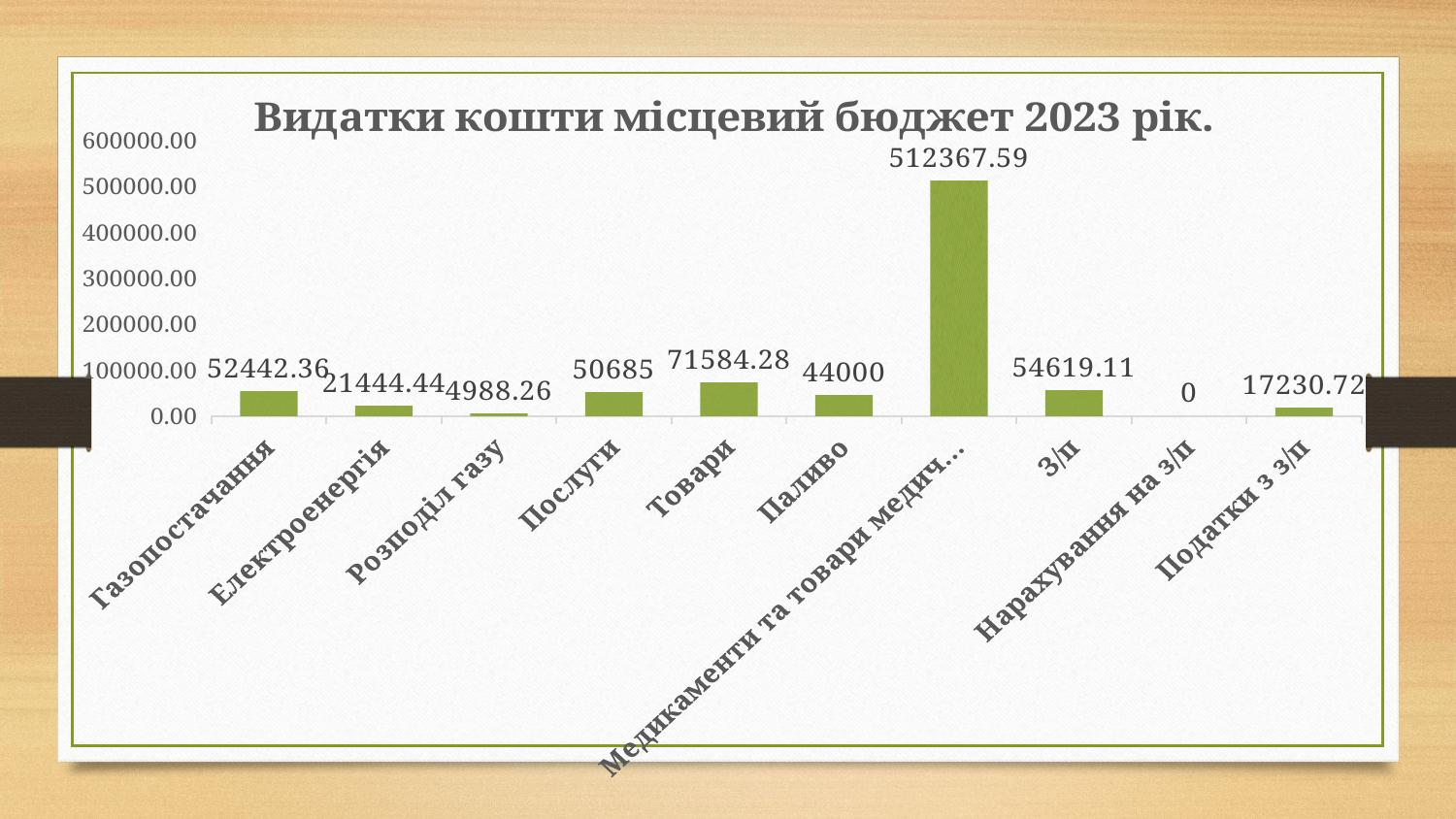
How many categories are shown on the x axis? 10 Which category has the highest value? Медикаменти та товари медич... What is the value for Газопостачання? 52442.36 Is the value for Медикаменти та товари медич... greater or less than 500000.00? greater What is the difference between the values for Товари and Паливо? 27584.28 Which is larger, the value for Послуги or the value for З/п? З/п What is the value for Паливо? 44000 What is the title of the chart? Видатки кошти місцевий бюджет 2023 рік. What is the value for Податки з з/п? 17230.72 What is the value for Товари? 71584.28 What kind of chart is this? bar chart Which category has the lowest value? Нарахування на з/п